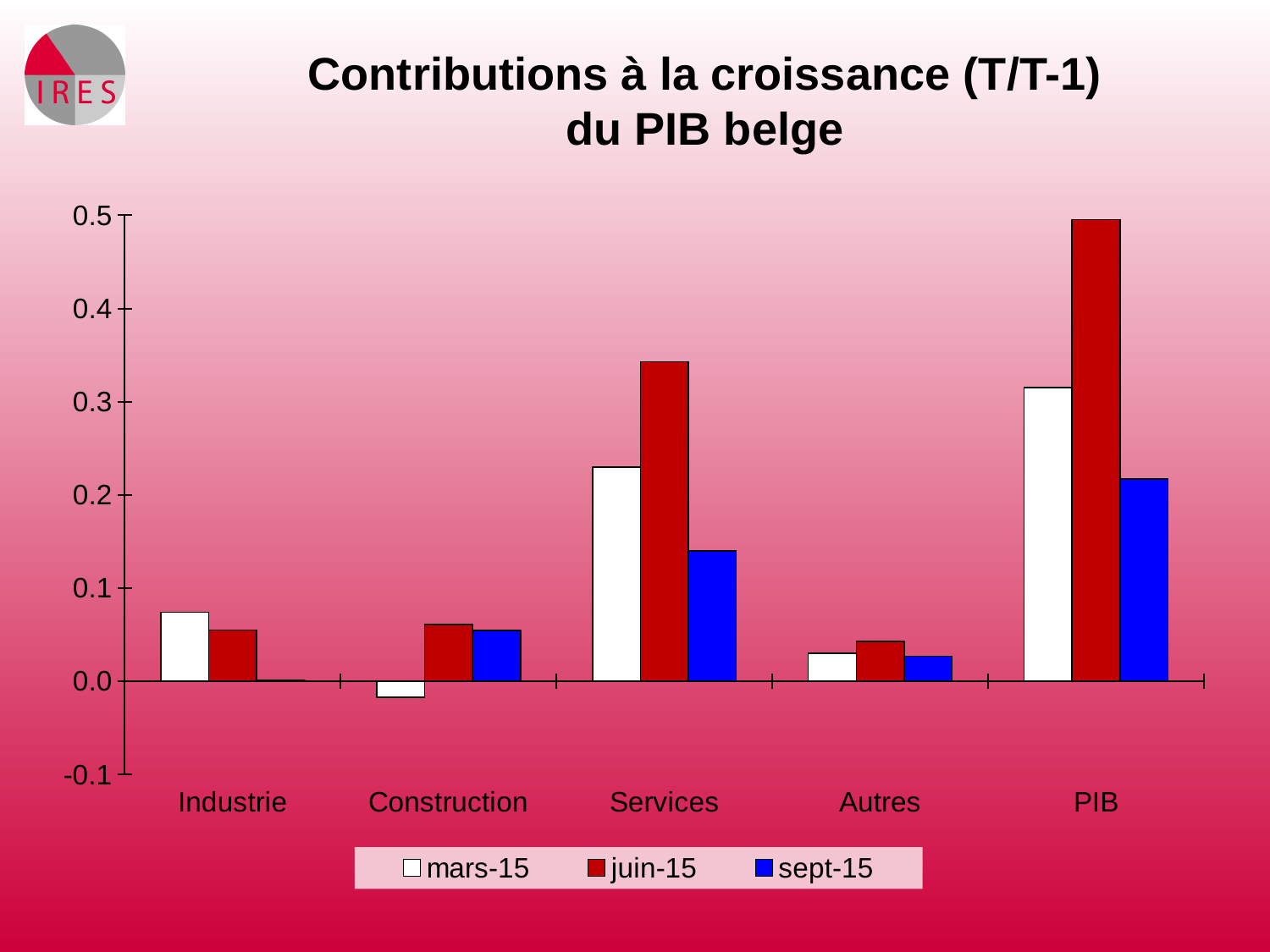
Which category has the lowest mars-15 value? Construction For Services, which is larger: the mars-15 value or the sept-15 value? mars-15 For Industrie, which is larger: the mars-15 value or the juin-15 value? mars-15 Which category has the highest juin-15 value? PIB Is the mars-15 value for PIB greater or less than 0.4? less How many series does the legend list? 3 Is the juin-15 value for Services greater or less than 0.3? greater How many categories are shown on the x axis? 5 Is the sept-15 value for Services greater or less than 0.1? greater What is the title of the chart? Contributions à la croissance (T/T-1) du PIB belge What kind of chart is shown on the slide? bar chart